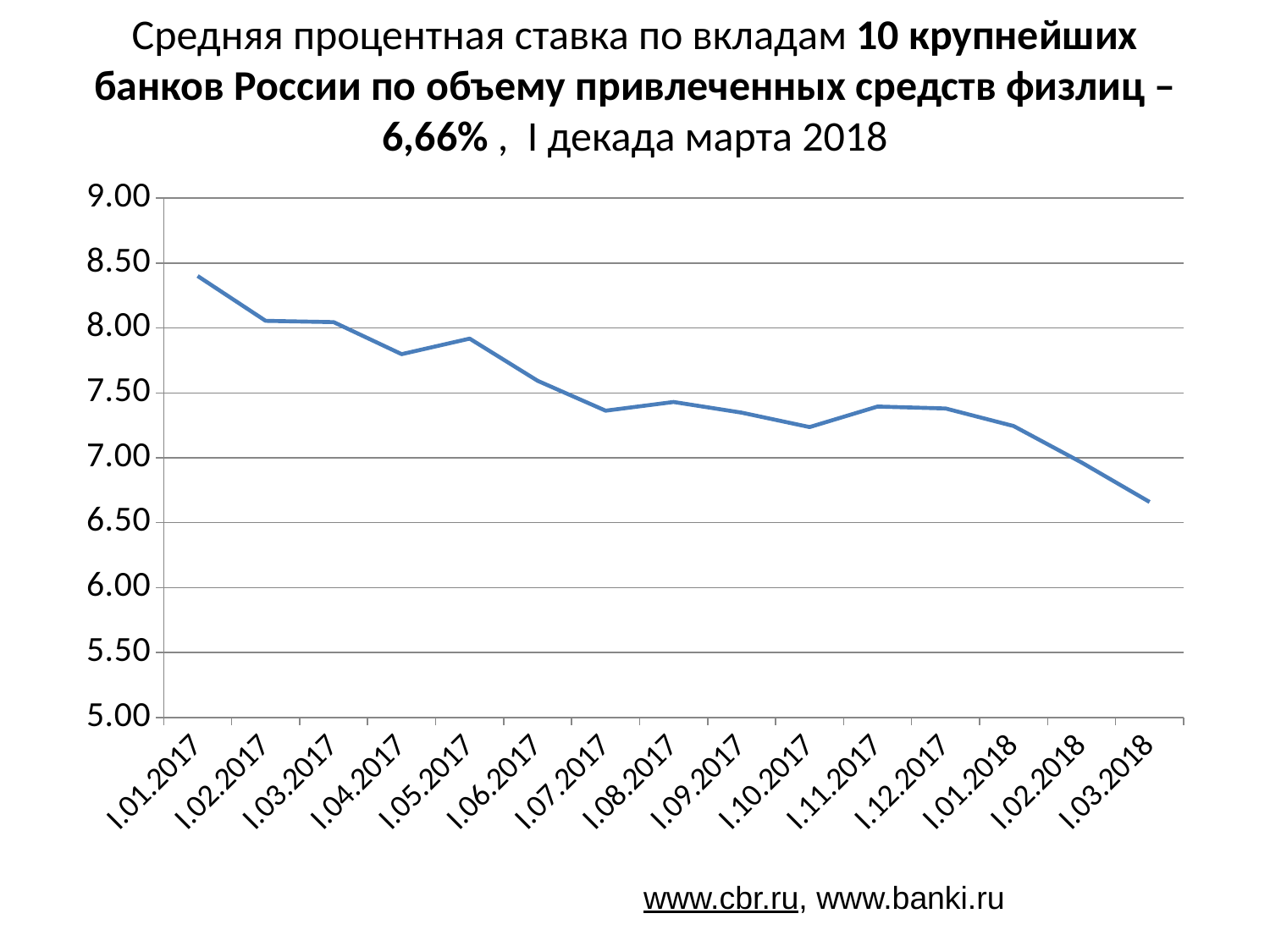
Is the value for I.04.2017 greater or less than 8.00? less How many data points (dates) are plotted along the x axis? 15 What kind of chart is shown on the slide? line chart Do the values generally rise or fall from I.01.2017 to I.03.2018? fall Which date has the lowest value on the chart? I.03.2018 Which is larger, the value for I.10.2017 or the value for I.11.2017? I.11.2017 Is the value for I.07.2017 greater or less than 7.50? less Is the value for I.01.2017 greater or less than 8.00? greater What sources are cited at the bottom of the slide? www.cbr.ru, www.banki.ru Which date has the highest value on the chart? I.01.2017 What is the average deposit rate for I декада марта 2018 as stated in the title? 6,66%